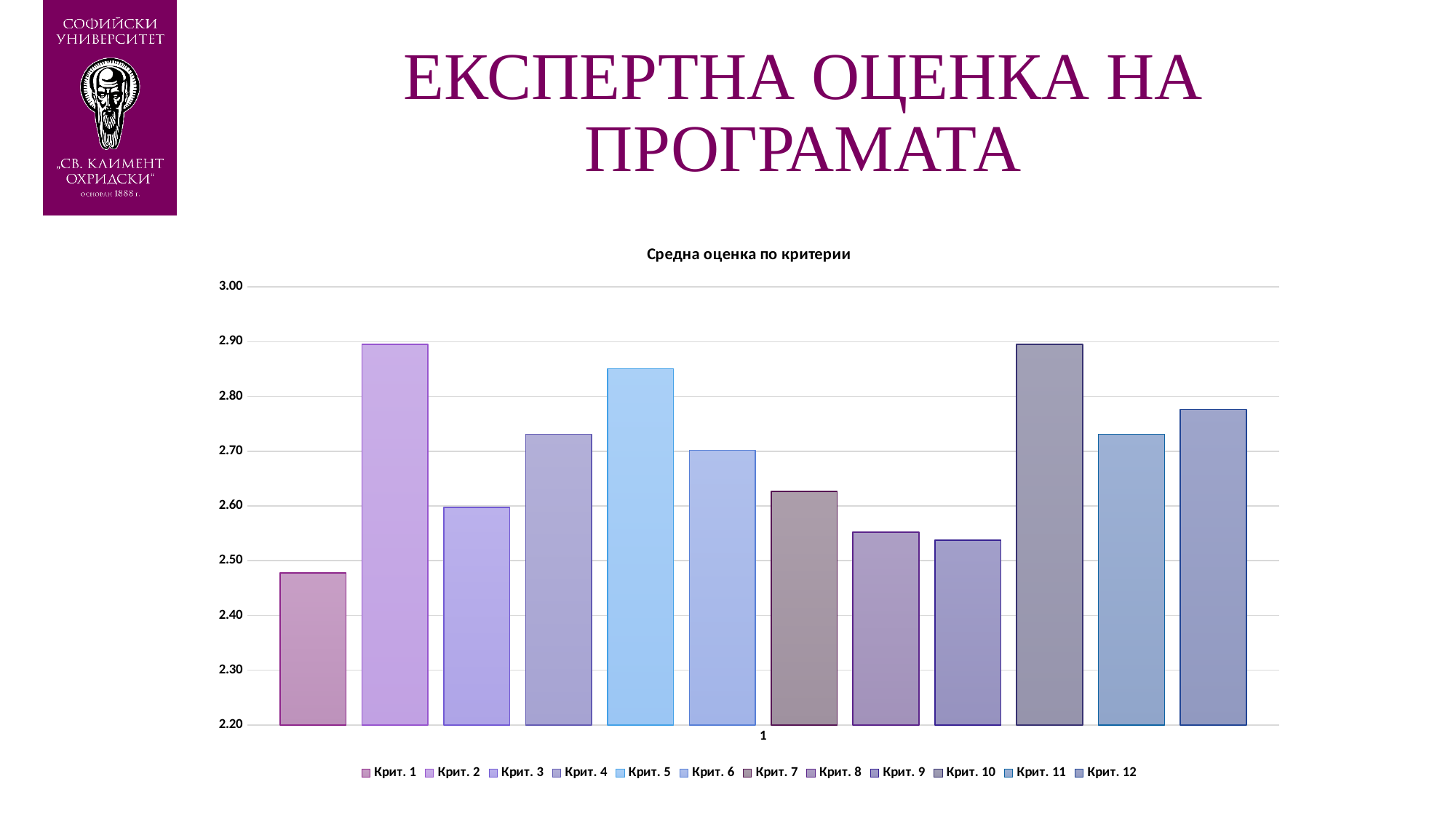
Is the value for Крит. 12 greater or less than 2.80? less How many series does the chart legend list? 12 Is the value for Крит. 2 greater or less than 2.80? greater Which has a higher value, Крит. 5 or Крит. 6? Крит. 5 Which has a higher value, Крит. 9 or Крит. 10? Крит. 10 What kind of chart is shown on the slide? Bar chart Is the value for Крит. 5 greater or less than 2.80? greater Which criterion has the lowest average score? Крит. 1 What is the highest value shown on the vertical axis? 3.00 What is the title of the chart? Средна оценка по критерии